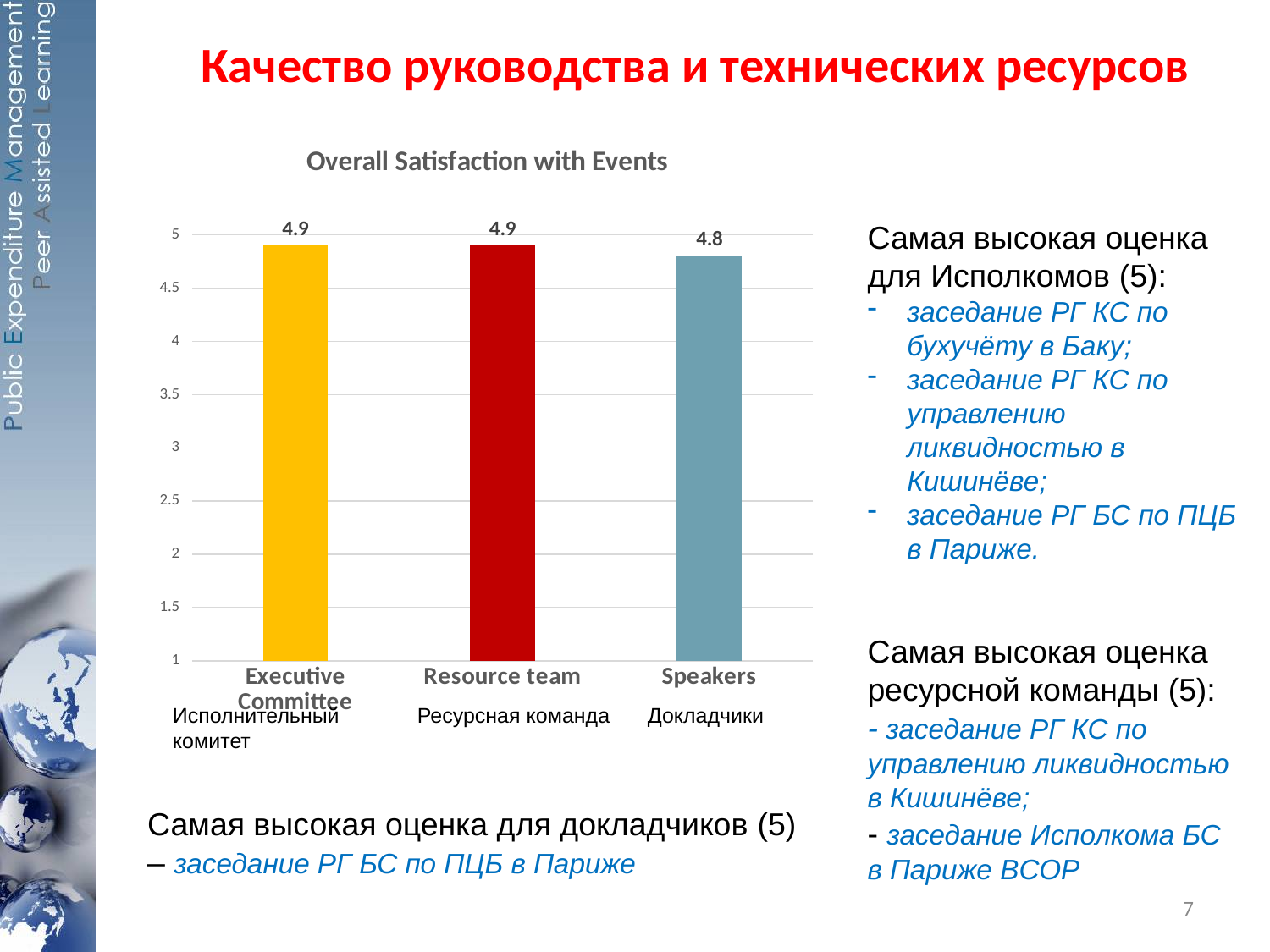
What is the difference between the values for Executive Committee and Speakers? 0.1 Which is larger, the value for Resource team or the value for Speakers? Resource team How many categories are shown in the Overall Satisfaction with Events chart? 3 What colour is the Resource team bar in the chart? red What is the value for Resource team in the Overall Satisfaction with Events chart? 4.9 What is the value for Executive Committee in the Overall Satisfaction with Events chart? 4.9 What is the title of the chart on the slide? Overall Satisfaction with Events What kind of chart is shown on the slide? bar chart Is the value for Speakers greater or less than 4.5? greater Which category has the lowest value in the Overall Satisfaction with Events chart? Speakers What is the value for Speakers in the Overall Satisfaction with Events chart? 4.8